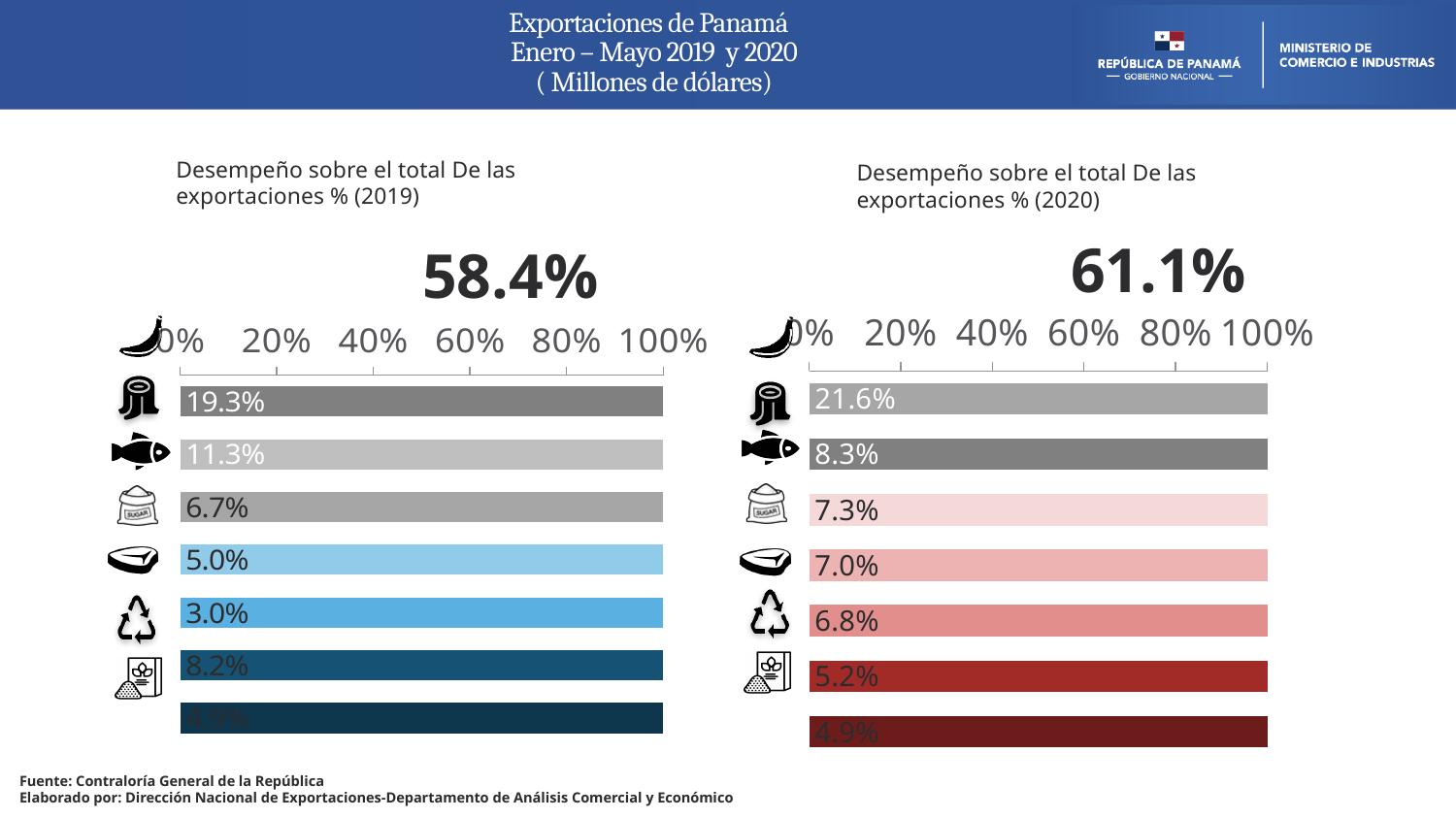
In the 2020 chart on the right, what value is labelled on the first (top) bar? 21.6% In the 2019 chart on the left, how many bars are plotted? 7 What large percentage figure is displayed above the 2019 chart on the left? 58.4% What is the difference between the top bar label in the 2020 chart (21.6%) and the top bar label in the 2019 chart (19.3%)? 2.3 percentage points What large percentage figure is displayed above the 2020 chart on the right? 61.1% What kind of chart is used on the left side of the slide for 'Desempeño sobre el total De las exportaciones % (2019)'? bar chart In the 2020 chart on the right, what value is labelled on the third bar? 7.3% Which chart has the larger value on its second bar: the 2019 chart (11.3%) or the 2020 chart (8.3%)? 2019 chart In the 2019 chart on the left, what is the largest data label shown? 19.3% In the 2019 chart on the left, what is the smallest clearly readable data label? 3.0% In the 2020 chart on the right, what is the largest data label shown? 21.6% In the 2019 chart on the left, what value is labelled on the first (top) bar? 19.3%